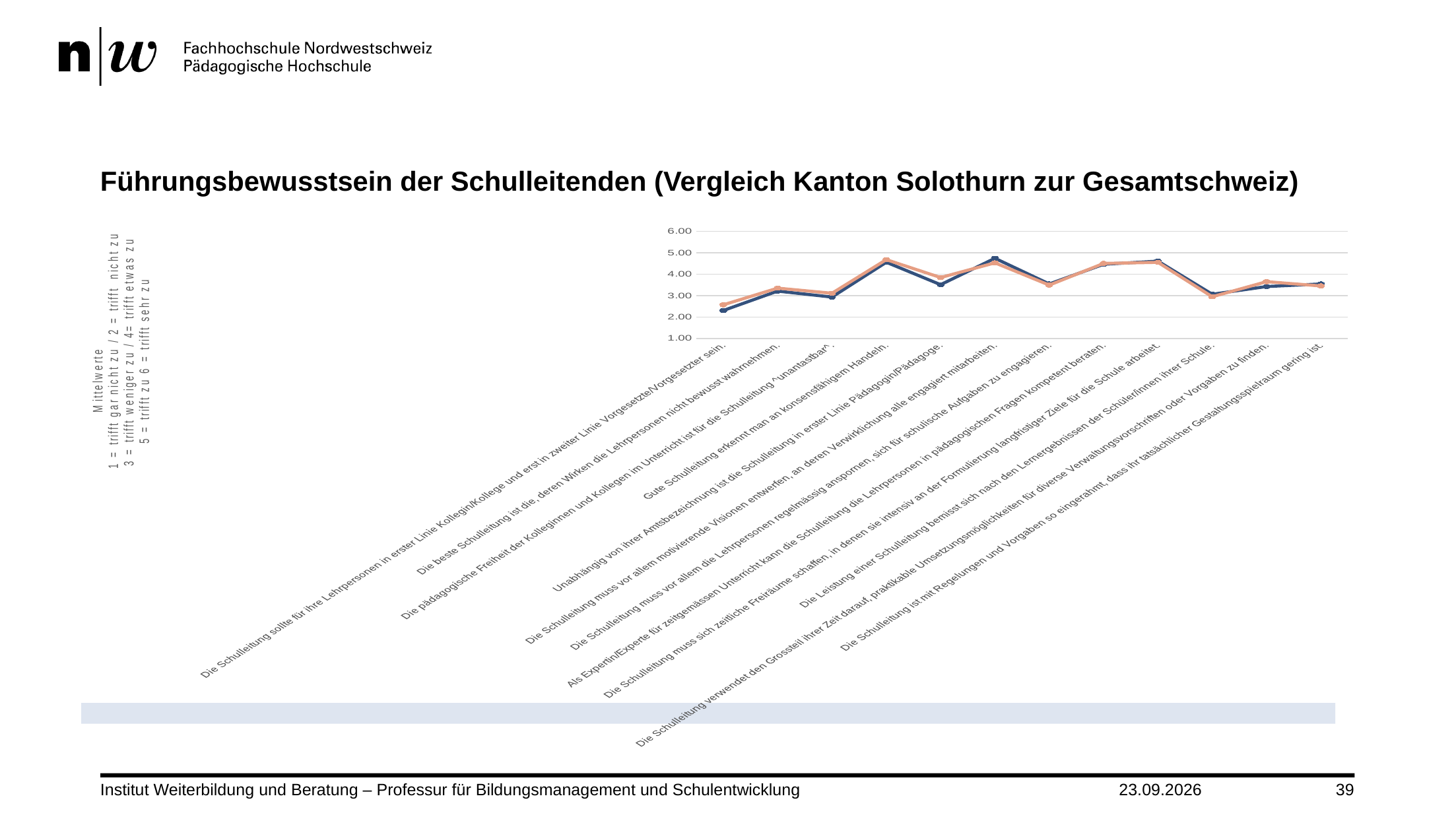
Is the value for "Die Schulleitung muss vor allem motivierende Visionen entwerfen, an deren Verwirklichung alle engagiert mitarbeiten." greater or less than 4.00? greater Which has the larger value: "Die Schulleitung sollte für ihre Lehrpersonen in erster Linie Kollegin/Kollege und erst in zweiter Linie Vorgesetzte/Vorgesetzter sein." or "Gute Schulleitung erkennt man an konsensfähigem Handeln."? Gute Schulleitung erkennt man an konsensfähigem Handeln. Is the value for "Die Schulleitung sollte für ihre Lehrpersonen in erster Linie Kollegin/Kollege und erst in zweiter Linie Vorgesetzte/Vorgesetzter sein." greater or less than 3.00? less Is the value for "Gute Schulleitung erkennt man an konsensfähigem Handeln." greater or less than 4.00? greater What kind of chart is shown on the slide? line chart Which statement has the lowest values on both lines? Die Schulleitung sollte für ihre Lehrpersonen in erster Linie Kollegin/Kollege und erst in zweiter Linie Vorgesetzte/Vorgesetzter sein. How many statements (categories) are plotted along the x axis? 12 What is the highest tick value shown on the y axis? 6.00 How many lines are plotted in the chart? 2 What is the title of the slide's chart? Führungsbewusstsein der Schulleitenden (Vergleich Kanton Solothurn zur Gesamtschweiz) Do the lines rise or fall from the first statement to the second statement on the x axis? rise